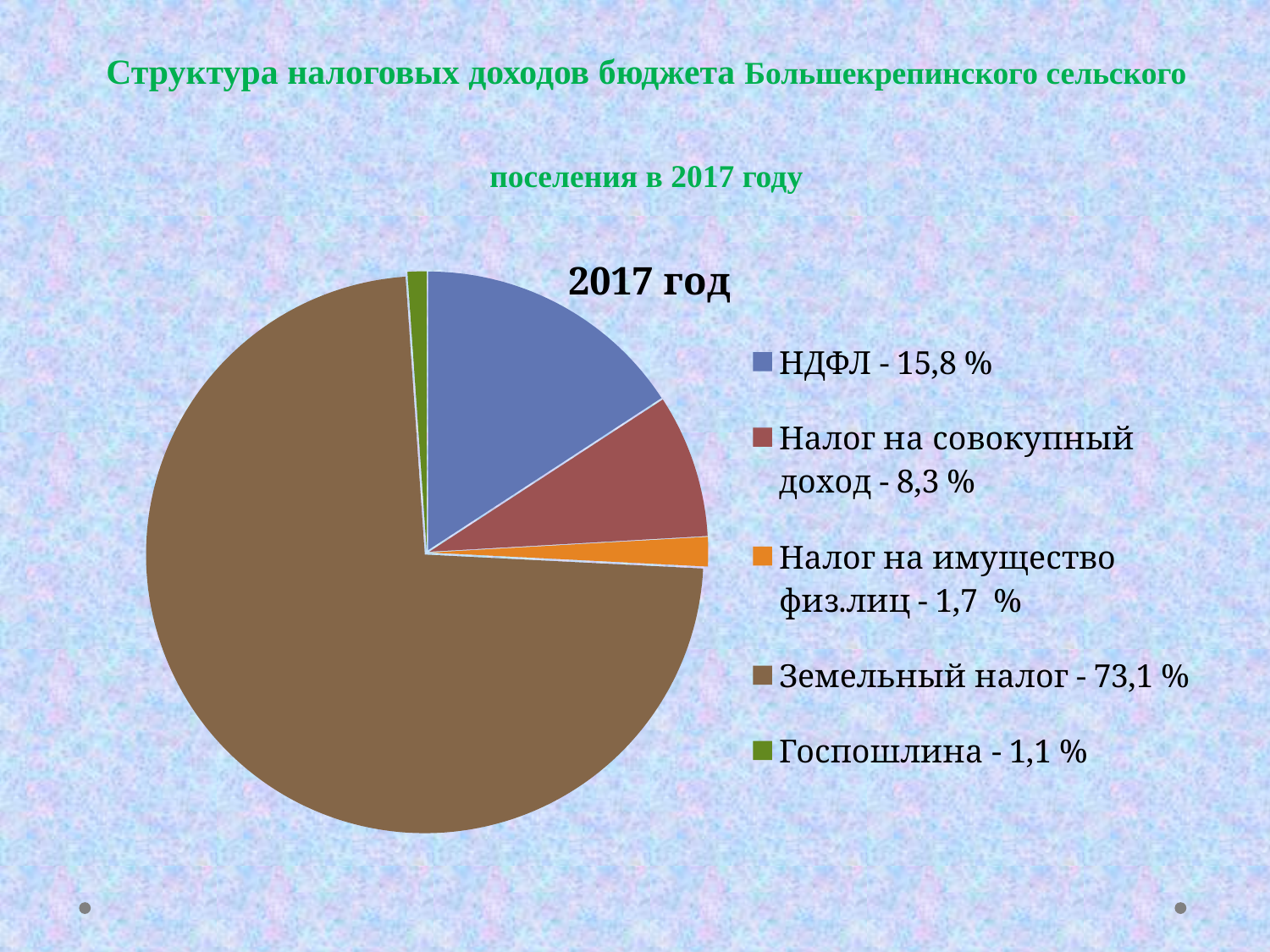
What is the share of Госпошлина in the pie chart? 1,1 % What is the title shown above the pie chart's legend? 2017 год Which category has the smallest slice of the pie chart? Госпошлина What is the difference between the share of Налог на имущество физ.лиц and the share of Госпошлина? 0,6 % What type of chart is shown on the slide? Pie chart Which category has the largest slice of the pie chart? Земельный налог How many categories does the pie chart have? 5 Which is larger: the share of НДФЛ or the share of Налог на совокупный доход? НДФЛ What is the difference between the share of Земельный налог and the share of НДФЛ? 57,3 % What is the share of НДФЛ in the pie chart? 15,8 % What is the share of Налог на совокупный доход in the pie chart? 8,3 % What is the share of Земельный налог in the pie chart? 73,1 %